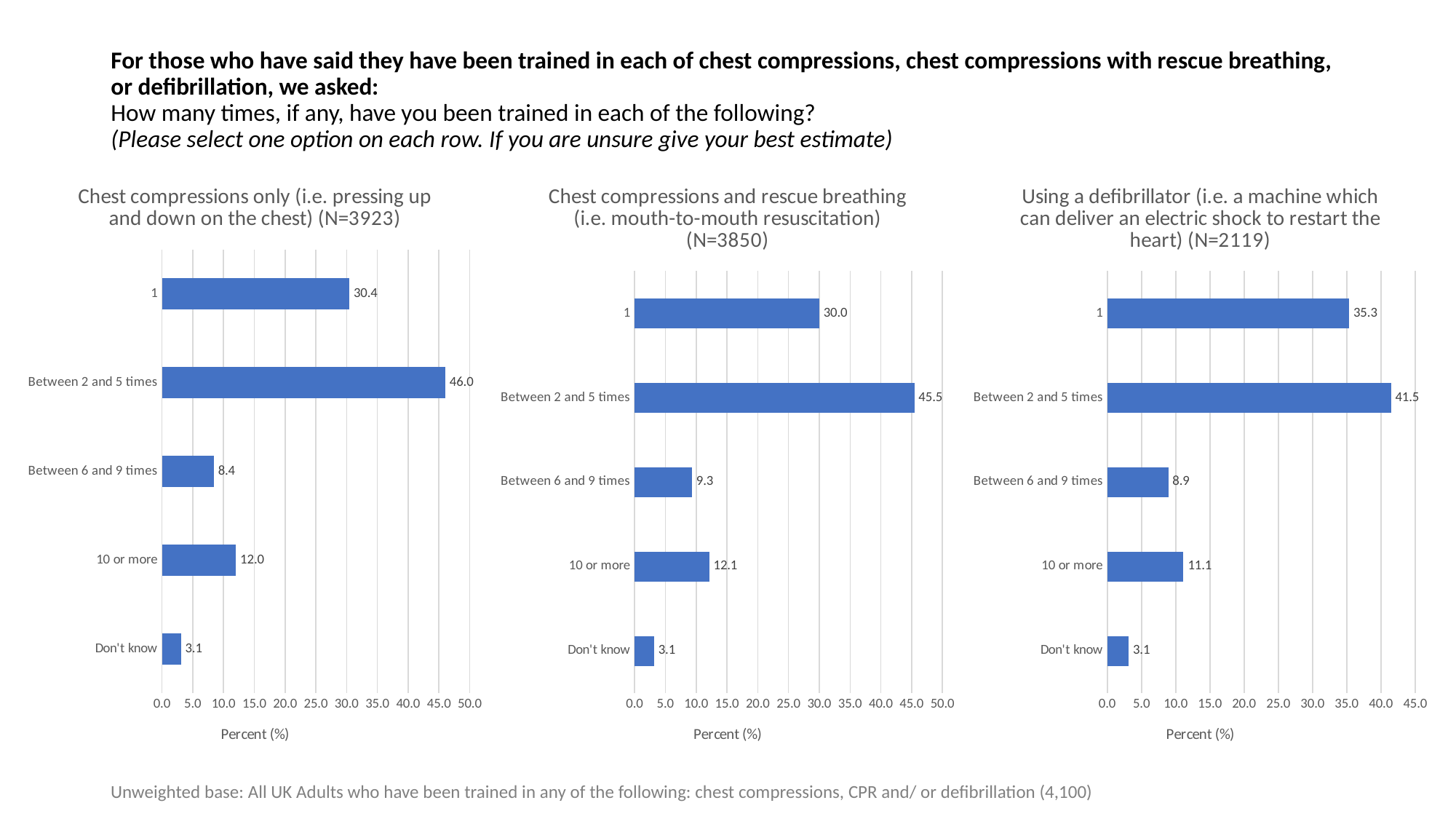
In the 'Chest compressions and rescue breathing' chart, what is the value for '10 or more'? 12.1 In the 'Using a defibrillator' chart, what is the value for '1'? 35.3 In the 'Using a defibrillator' chart, which category has the highest value? Between 2 and 5 times How many categories are shown in the 'Chest compressions only' chart? 5 In the 'Chest compressions and rescue breathing' chart, which category has the lowest value? Don't know What type of chart is the 'Chest compressions and rescue breathing' chart? Bar chart In the 'Using a defibrillator' chart, which is larger: the value for 'Between 6 and 9 times' or the value for '10 or more'? 10 or more In the 'Chest compressions only' chart, what is the difference between the values for 'Between 2 and 5 times' and '1'? 15.6 In the 'Chest compressions and rescue breathing' chart, what is the difference between the values for 'Between 6 and 9 times' and 'Don't know'? 6.2 What is the sample size (N) given in the title of the 'Using a defibrillator' chart? N=2119 In the 'Chest compressions only' chart, what is the value for 'Between 2 and 5 times'? 46.0 What is the axis title shown below each of the three charts? Percent (%)